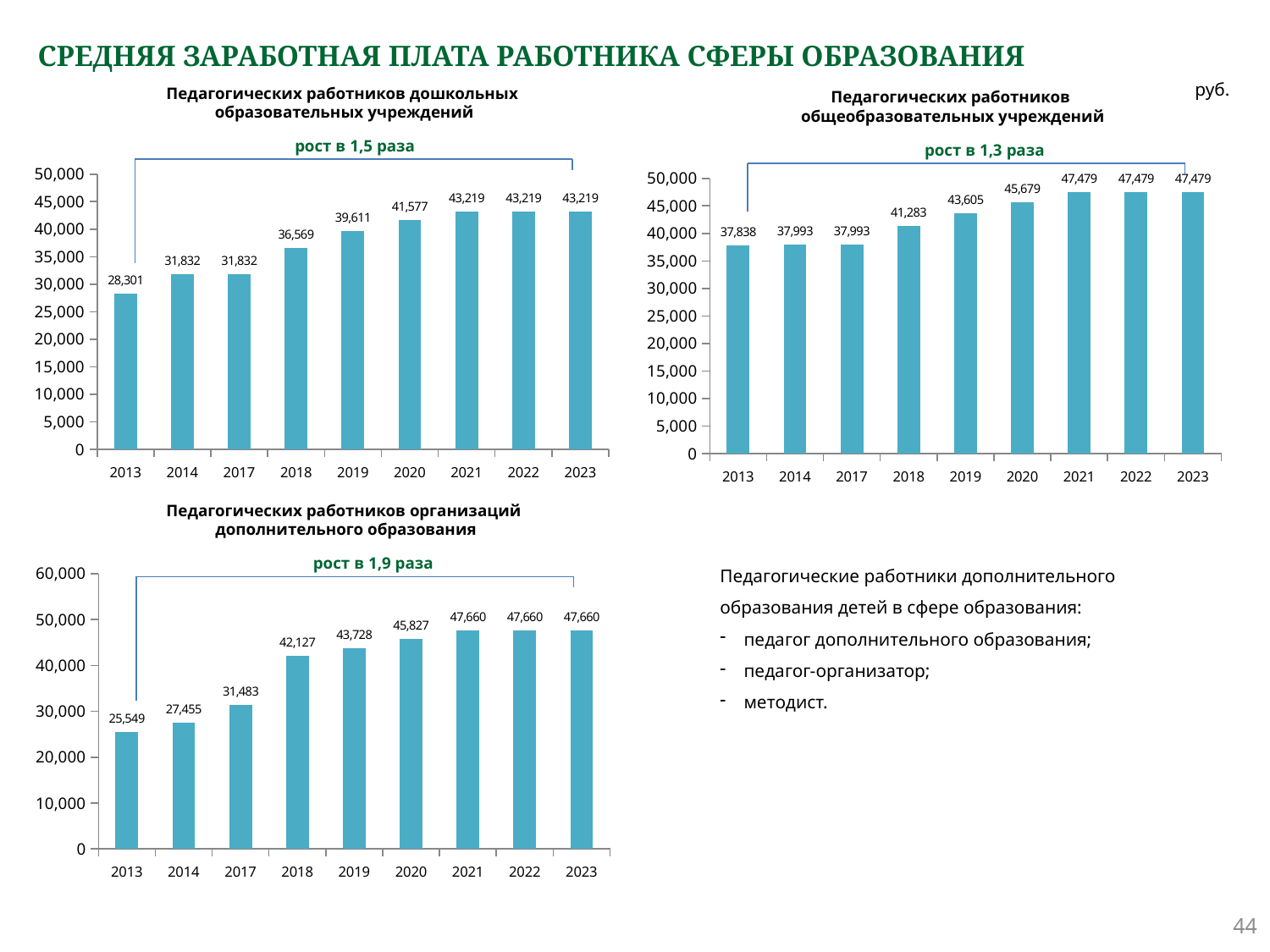
In the top-left chart (Педагогических работников дошкольных образовательных учреждений), what is the value for 2013? 28,301 In the bottom-left chart (Педагогических работников организаций дополнительного образования), which year has the lowest value? 2013 In the top-left chart (Педагогических работников дошкольных образовательных учреждений), what is the difference between the 2023 value and the 2013 value? 14,918 In the top-right chart (Педагогических работников общеобразовательных учреждений), what is the value for 2018? 41,283 In the bottom-left chart (Педагогических работников организаций дополнительного образования), what is the value for 2017? 31,483 What type of chart is the bottom-left chart (Педагогических работников организаций дополнительного образования)? Bar chart In the top-right chart (Педагогических работников общеобразовательных учреждений), which is larger: the value for 2019 or the value for 2020? 2020 How many years are shown on the x axis of the top-left chart (Педагогических работников дошкольных образовательных учреждений)? 9 In the bottom-left chart (Педагогических работников организаций дополнительного образования), what is the difference between the 2018 value and the 2017 value? 10,644 In the top-right chart (Педагогических работников общеобразовательных учреждений), what growth factor is stated in the green annotation above the bars? рост в 1,3 раза In the top-right chart (Педагогических работников общеобразовательных учреждений), what is the value for 2023? 47,479 In the top-left chart (Педагогических работников дошкольных образовательных учреждений), what is the value for 2019? 39,611